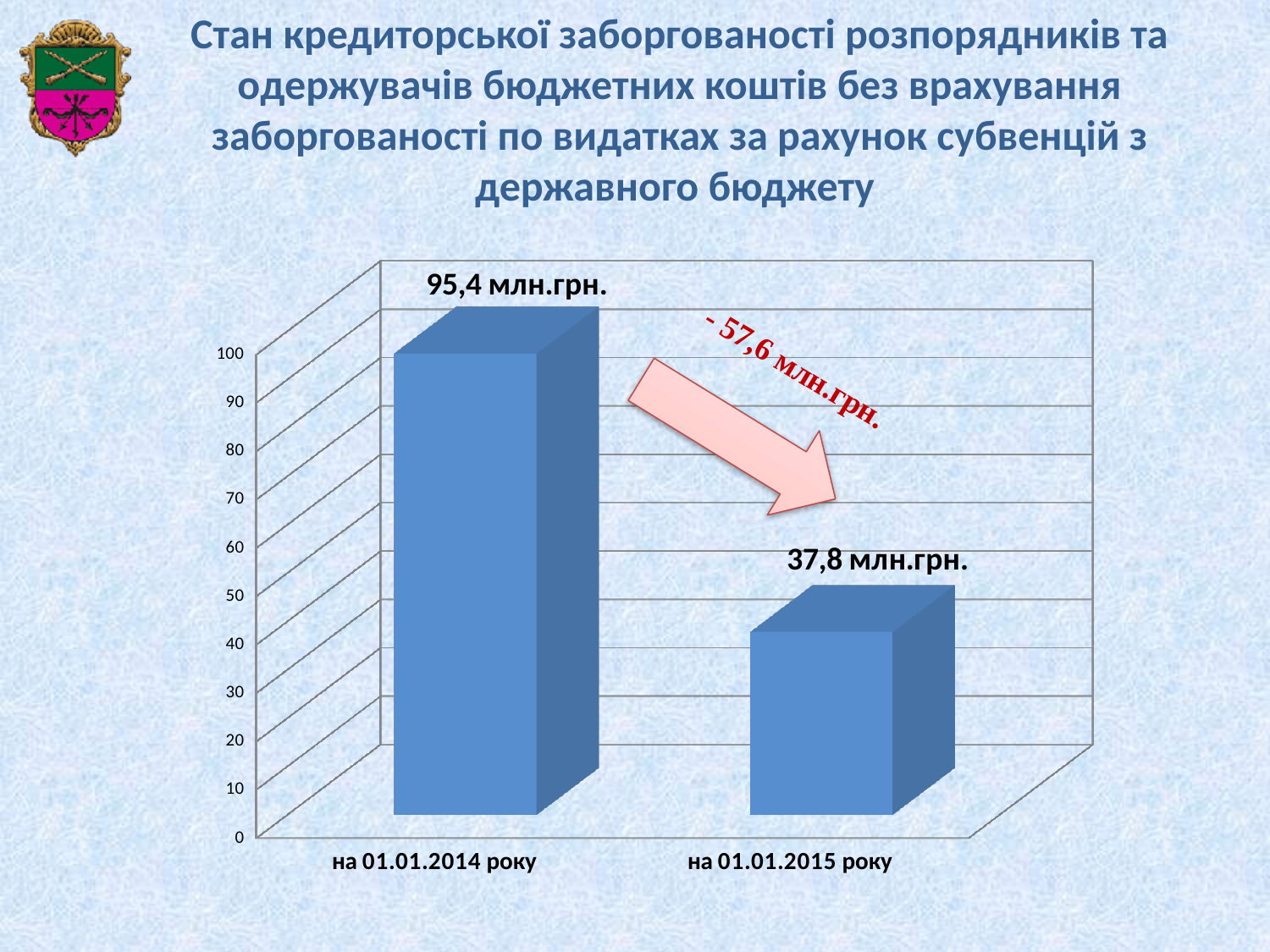
Which category has the lowest value? на 01.01.2015 року Which category has the highest value? на 01.01.2014 року What kind of chart is shown on the slide? bar chart What change is written in red next to the arrow on the chart? - 57,6 млн.грн. Which is larger, the value for на 01.01.2014 року or the value for на 01.01.2015 року? на 01.01.2014 року What is the value for на 01.01.2014 року? 95,4 млн.грн. What is the difference between the values for на 01.01.2014 року and на 01.01.2015 року? 57,6 млн.грн. What is the value for на 01.01.2015 року? 37,8 млн.грн. Is the value for на 01.01.2015 року greater or less than 50? less Is the value for на 01.01.2014 року greater or less than 90? greater Do the values rise or fall from на 01.01.2014 року to на 01.01.2015 року? fall How many categories are shown on the x axis? 2